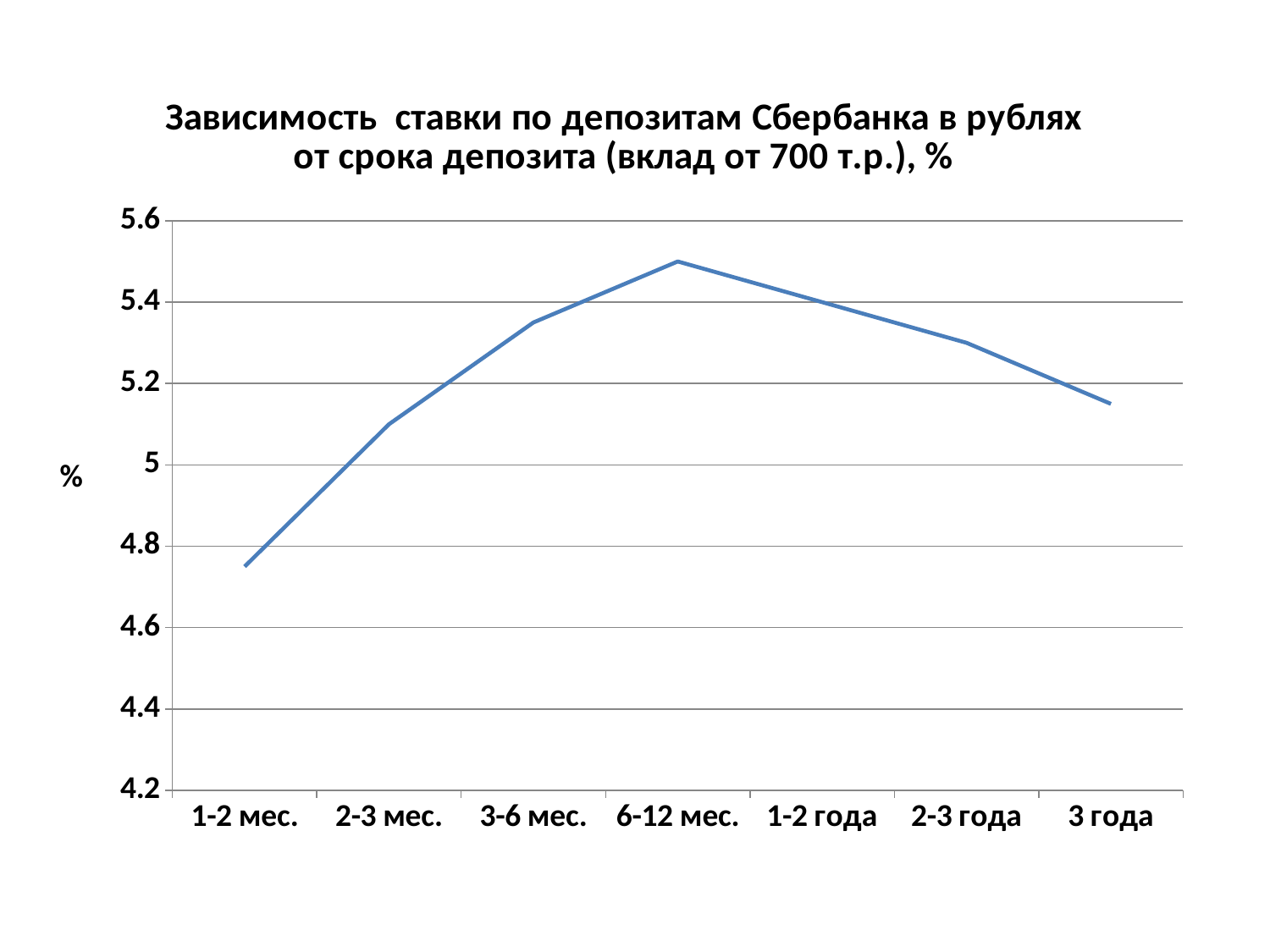
Is the value for 1-2 мес. greater or less than 5? less What label is shown on the vertical axis? % Is the value for 2-3 мес. greater or less than 5? greater What kind of chart is shown on the slide? line chart Which deposit term has the highest rate? 6-12 мес. Is the value for 2-3 года greater or less than 5.4? less Which deposit term has the lowest rate? 1-2 мес. How does the rate change along the x axis from 6-12 мес. to 3 года? it falls Which is larger, the value for 3-6 мес. or the value for 3 года? 3-6 мес. How many deposit term categories are shown on the x axis? 7